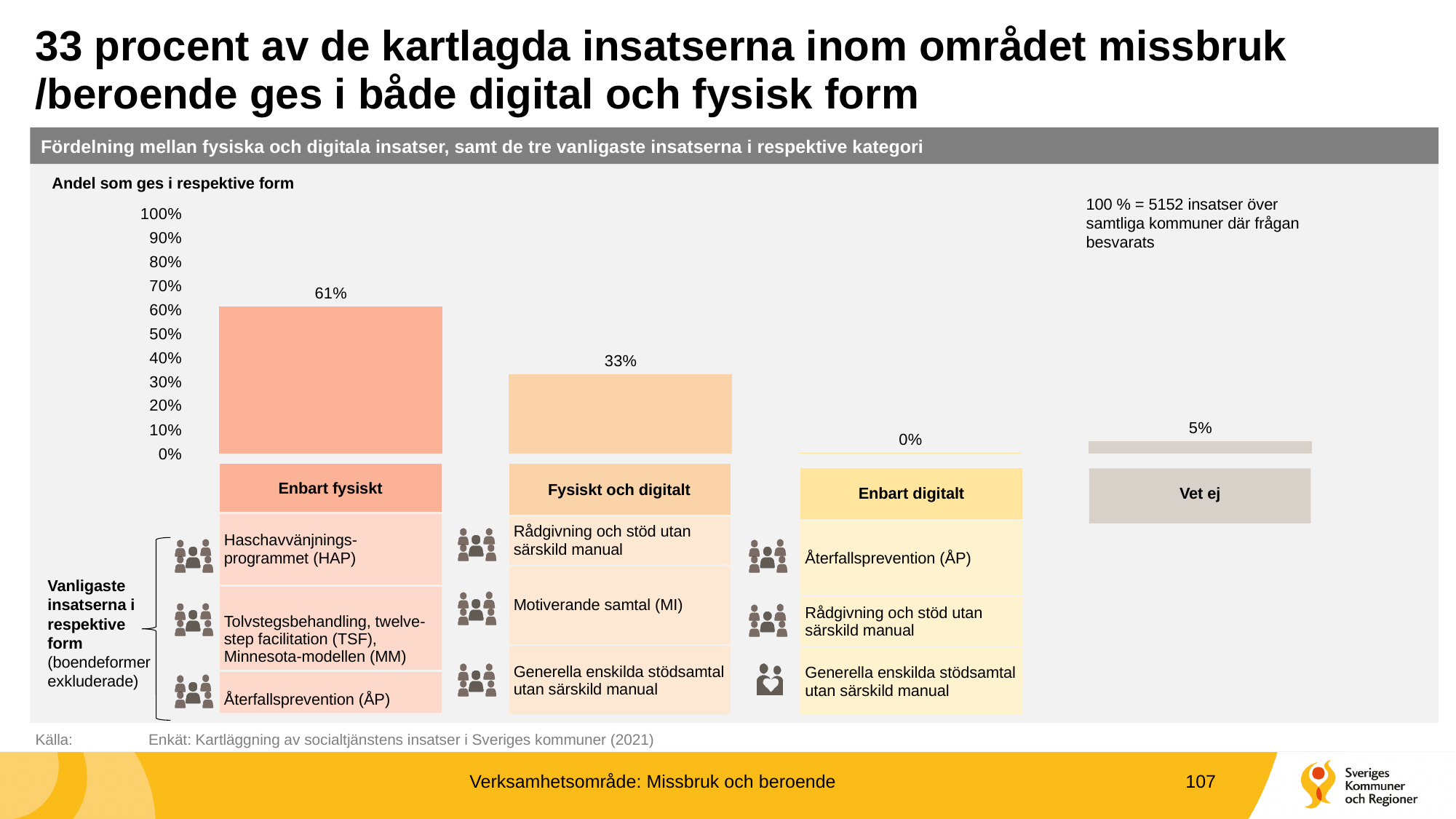
What is the total number of insatser that 100% corresponds to, according to the note on the chart? 5152 What is the difference between the values for "Enbart fysiskt" and "Fysiskt och digitalt"? 28 percentage points What is the value for "Fysiskt och digitalt"? 33% Is the value for "Enbart fysiskt" greater or less than 50%? greater Which category has the lowest value? Enbart digitalt What kind of chart is shown on the slide? Bar chart What is the value for "Enbart fysiskt"? 61% Which is larger, the value for "Fysiskt och digitalt" or the value for "Vet ej"? Fysiskt och digitalt What is the value for "Vet ej"? 5% What is the value for "Enbart digitalt"? 0% How many categories are shown in the bar chart? 4 Which category has the highest value? Enbart fysiskt